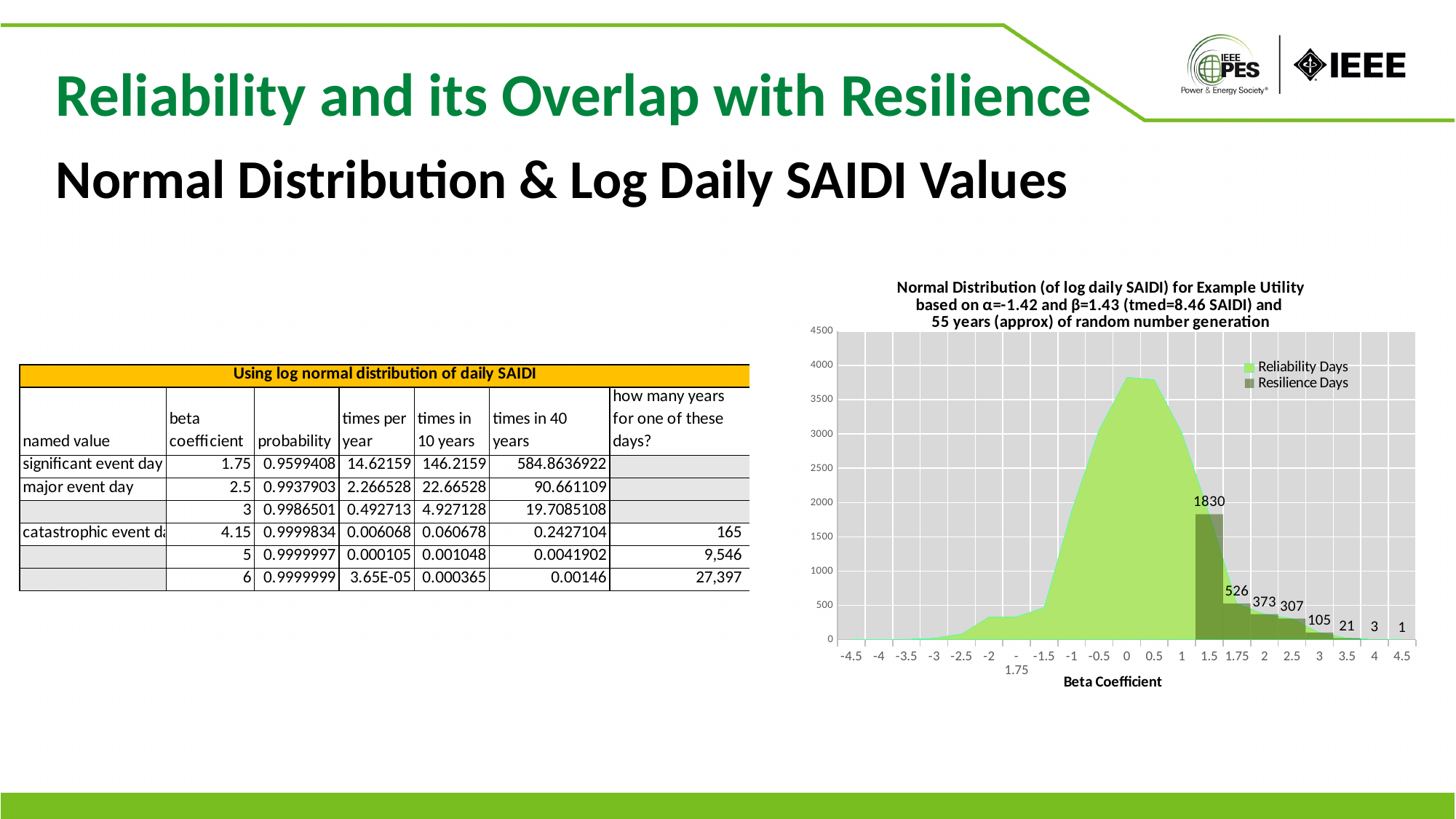
What type of chart is shown on the slide? combination area and bar chart At which beta coefficient is the labelled Resilience Days value lowest? 4.5 What is the difference between the Resilience Days values at beta coefficient 1.5 and 1.75? 1304 What are the two series named in the chart legend? Reliability Days and Resilience Days How many series does the chart legend list? 2 What is the Resilience Days value labelled at beta coefficient 2.5? 307 At which beta coefficient is the labelled Resilience Days value highest? 1.5 What is the x-axis title of the chart? Beta Coefficient Do the labelled Resilience Days values rise or fall as the beta coefficient increases from 1.5 to 4.5? fall What is the Resilience Days value labelled at beta coefficient 3.5? 21 What is the Resilience Days value labelled at beta coefficient 1.5? 1830 Is the Reliability Days value at beta coefficient 0.5 greater or less than 3500? greater